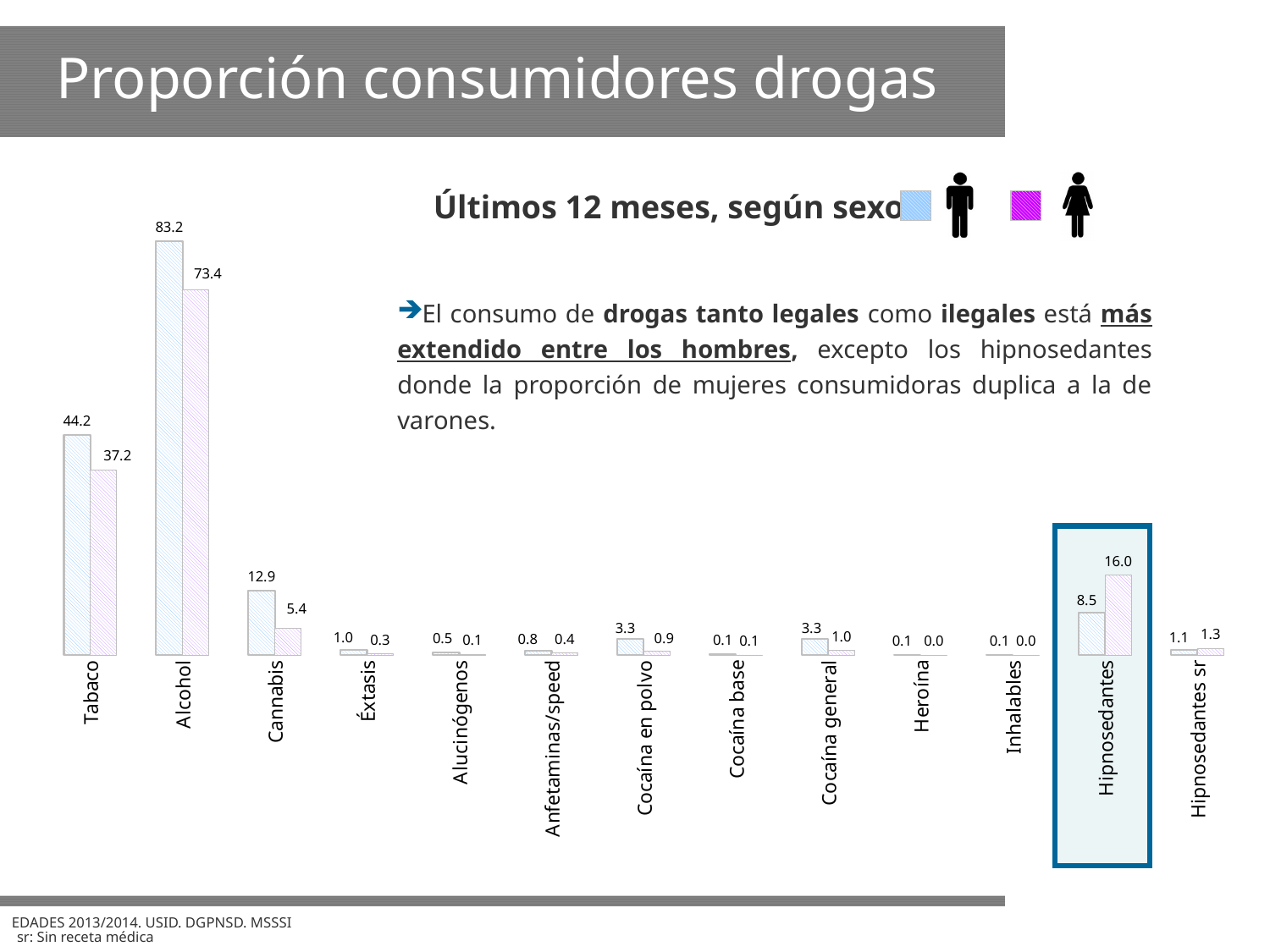
What is the value for men for Cannabis? 12.9 What is the value for women (magenta bar) for Tabaco? 37.2 What is the value for women for Hipnosedantes? 16.0 Which category has the highest value for men? Alcohol What is the value for men (blue bar) for Alcohol? 83.2 What is the difference between the men's and women's values for Alcohol? 9.8 What type of chart is shown on the slide? bar chart For Cannabis, which is larger: the value for men or the value for women? men What is the subtitle of the chart? Últimos 12 meses, según sexo What is the difference between the women's and men's values for Hipnosedantes? 7.5 For Hipnosedantes, which is larger: the value for men or the value for women? women How many drug categories are shown on the x axis of the chart? 13